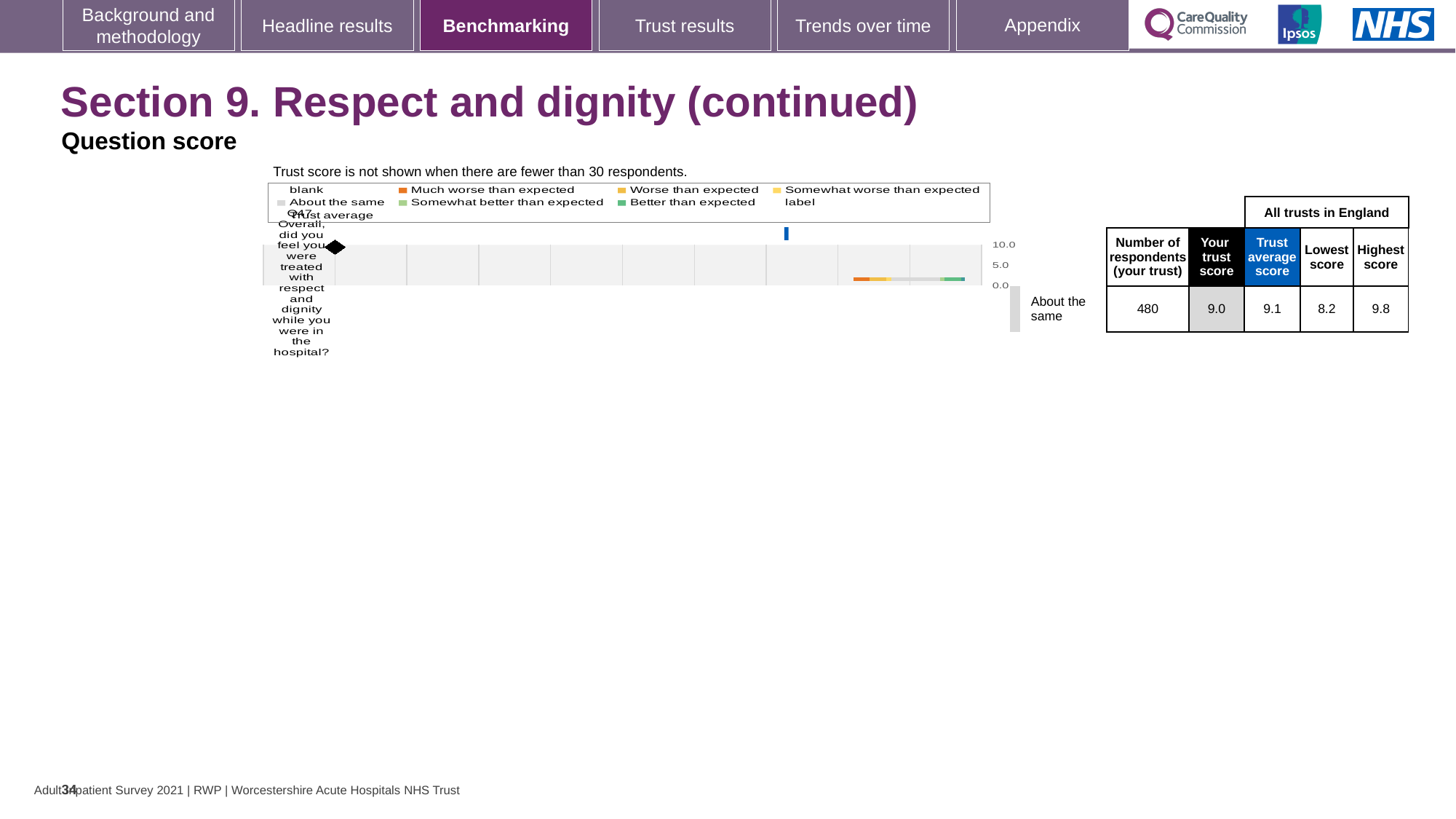
In the table beside the chart, what is the difference between the highest score and the lowest score among all trusts in England? 1.6 What is the highest tick value shown on the chart's axis? 10.0 In the table beside the chart, which is larger: your trust score or the trust average score? Trust average score In the table beside the chart, what is the highest score among all trusts in England? 9.8 In the table beside the chart, what is the trust average score for all trusts in England? 9.1 What kind of chart is shown on the slide? bar chart In the table beside the chart, what is the number of respondents for your trust? 480 In the table beside the chart, what is the lowest score among all trusts in England? 8.2 How many survey questions are plotted on the chart? 1 Which question number is plotted on the chart? Q47 What benchmarking category label is shown next to the chart for Q47? About the same In the table beside the chart, what is your trust score for Q47? 9.0